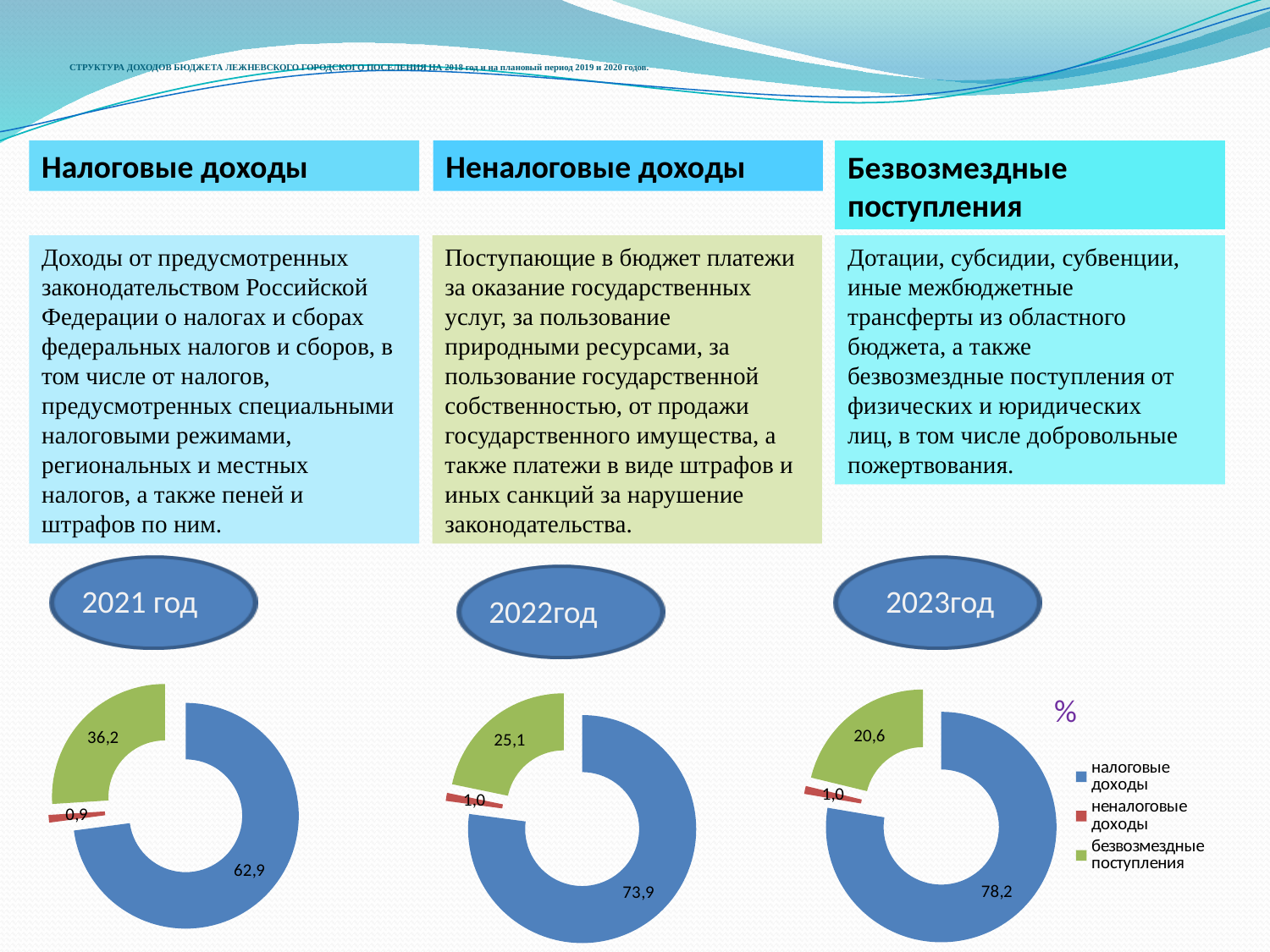
What kind of chart is used for the 2021 год data? doughnut chart In the 2021 год chart, what is the value for налоговые доходы? 62,9 In the legend next to the 2023год chart, which colour represents безвозмездные поступления? green In the 2022год chart, what is the value for безвозмездные поступления? 25,1 In the 2023год chart, which category has the largest share? налоговые доходы How many entries does the legend next to the 2023год chart list? 3 How many categories does the 2022год chart show? 3 Across the 2021 год, 2022год and 2023год charts, does the share of налоговые доходы rise or fall over the years? rise What is the difference between the налоговые доходы values in the 2023год chart and the 2021 год chart? 15,3 In the 2023год chart, what is the value for неналоговые доходы? 1,0 In the 2021 год chart, which category has the smallest share? неналоговые доходы Which is larger: безвозмездные поступления in the 2021 год chart or in the 2022год chart? 2021 год